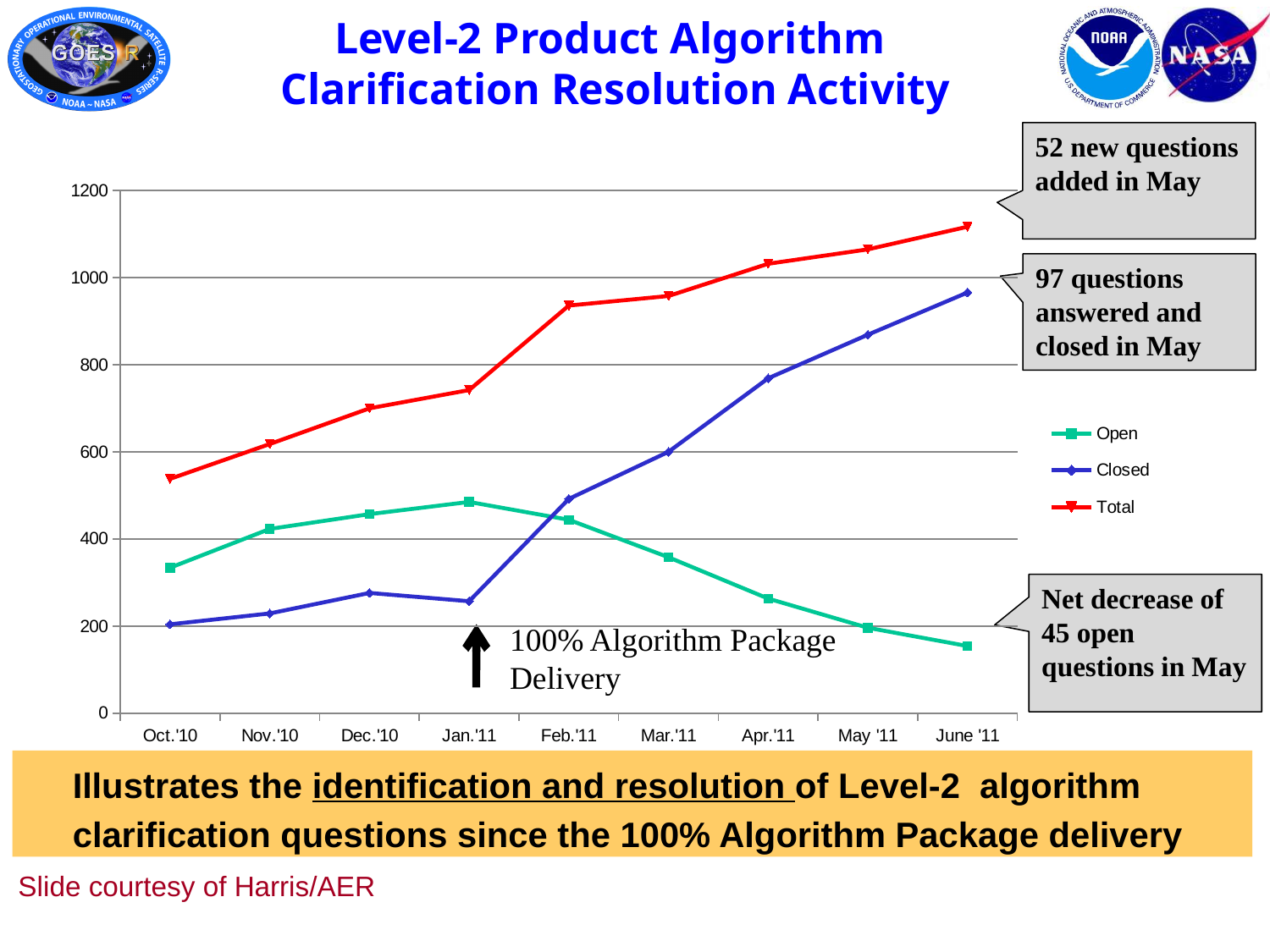
How many series does the legend list? 3 Is the value of the Total series in June '11 greater or less than 1000? greater Is the value of the Open series in June '11 greater or less than 200? less What kind of chart is shown on the slide? line chart Is the value of the Total series in Oct.'10 greater or less than 600? less How many months are plotted along the x axis? 9 In which month does the Open series reach its highest value? Jan.'11 In Oct.'10, which is larger, the Open value or the Closed value? Open Which series does the red line represent? Total Does the Total series rise or fall from Oct.'10 to June '11? rise In which month is the Open series at its lowest value? June '11